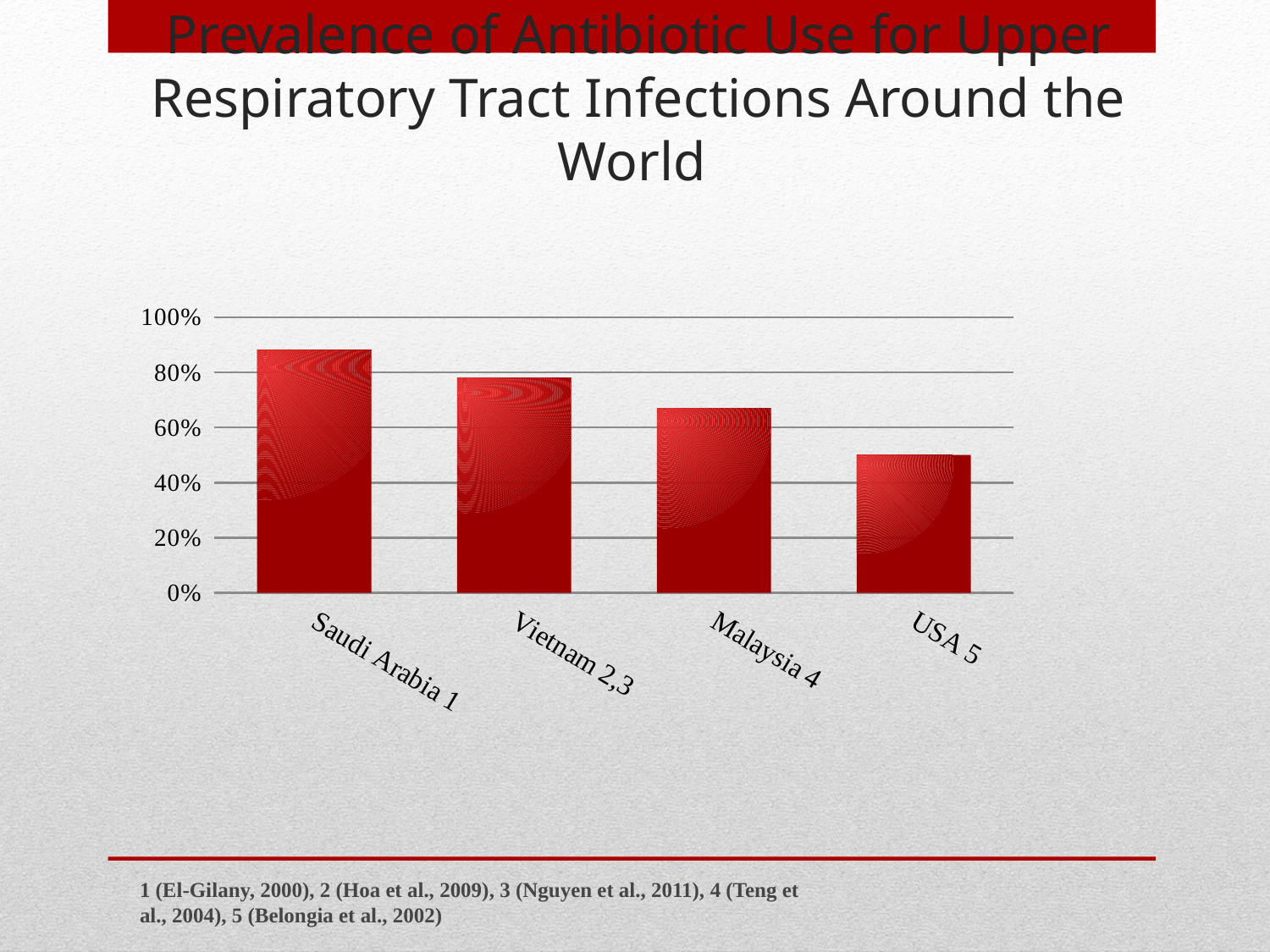
Which country has the highest prevalence of antibiotic use? Saudi Arabia 1 What is the title of the slide containing the chart? Prevalence of Antibiotic Use for Upper Respiratory Tract Infections Around the World Which is larger, the value for Vietnam 2,3 or the value for Malaysia 4? Vietnam 2,3 Is the value for Saudi Arabia 1 greater or less than 80%? greater How many countries are shown on the chart? 4 Is the value for Malaysia 4 greater or less than 80%? less Is the value for USA 5 greater or less than 40%? greater Which country has the lowest prevalence of antibiotic use? USA 5 What kind of chart is shown on the slide? bar chart Do the values rise or fall from left to right across the chart? fall